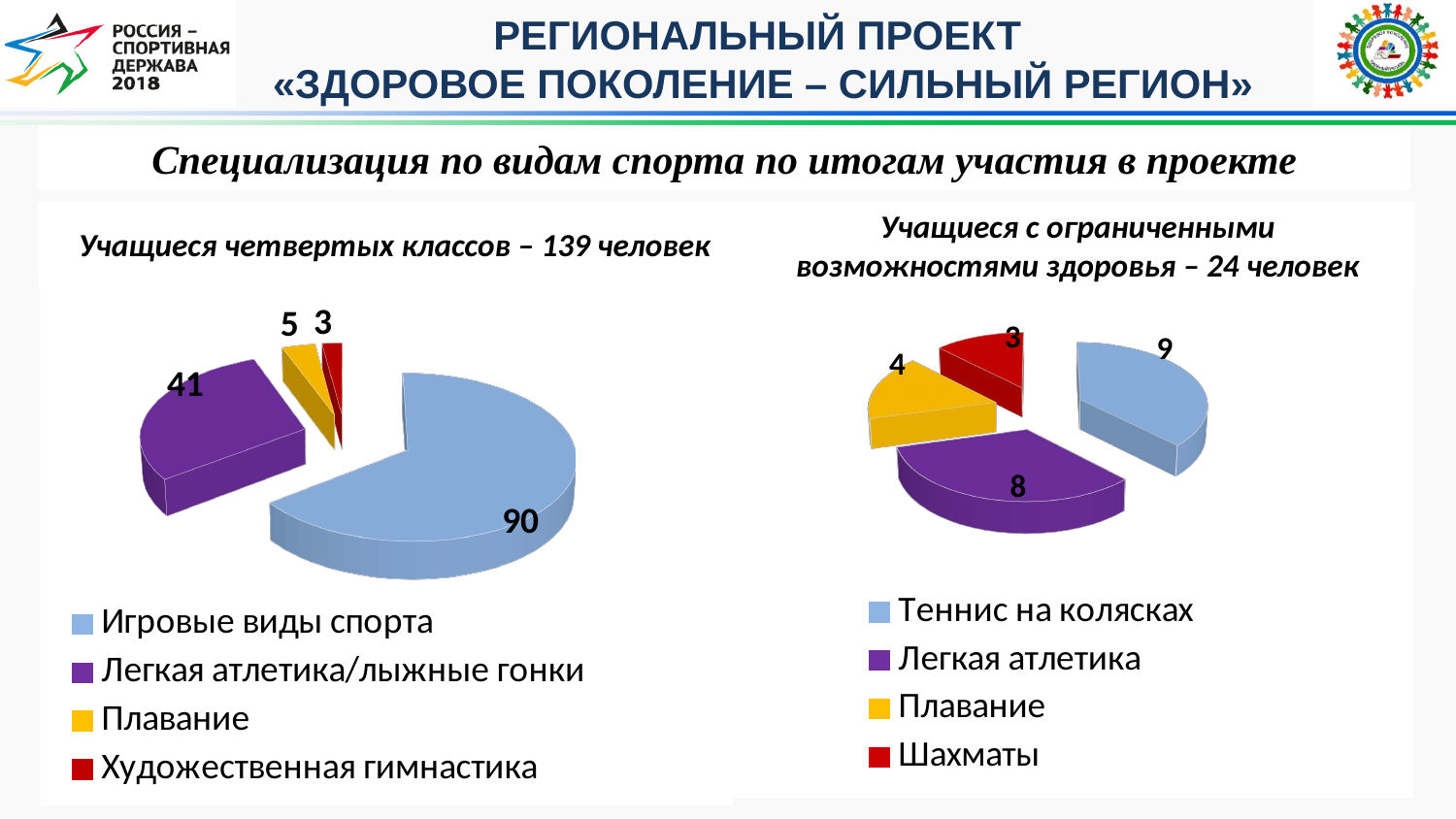
In the right chart (Учащиеся с ограниченными возможностями здоровья), what share of the total does Теннис на колясках represent? 37.5% In the left chart (Учащиеся четвертых классов), what is the value for Игровые виды спорта? 90 In the left chart (Учащиеся четвертых классов), what is the difference between Игровые виды спорта and Легкая атлетика/лыжные гонки? 49 What colour is the Плавание slice in the left chart (Учащиеся четвертых классов)? Yellow What type of chart is the left chart (Учащиеся четвертых классов)? Pie chart How many categories does the right chart (Учащиеся с ограниченными возможностями здоровья) show? 4 In the right chart (Учащиеся с ограниченными возможностями здоровья), which is larger: Плавание or Шахматы? Плавание In the left chart (Учащиеся четвертых классов), what is the value for Легкая атлетика/лыжные гонки? 41 In the right chart (Учащиеся с ограниченными возможностями здоровья), which category has the smallest slice? Шахматы In the left chart (Учащиеся четвертых классов), which category has the largest slice? Игровые виды спорта In the right chart (Учащиеся с ограниченными возможностями здоровья), what is the value for Теннис на колясках? 9 In the right chart (Учащиеся с ограниченными возможностями здоровья), what is the value for Шахматы? 3